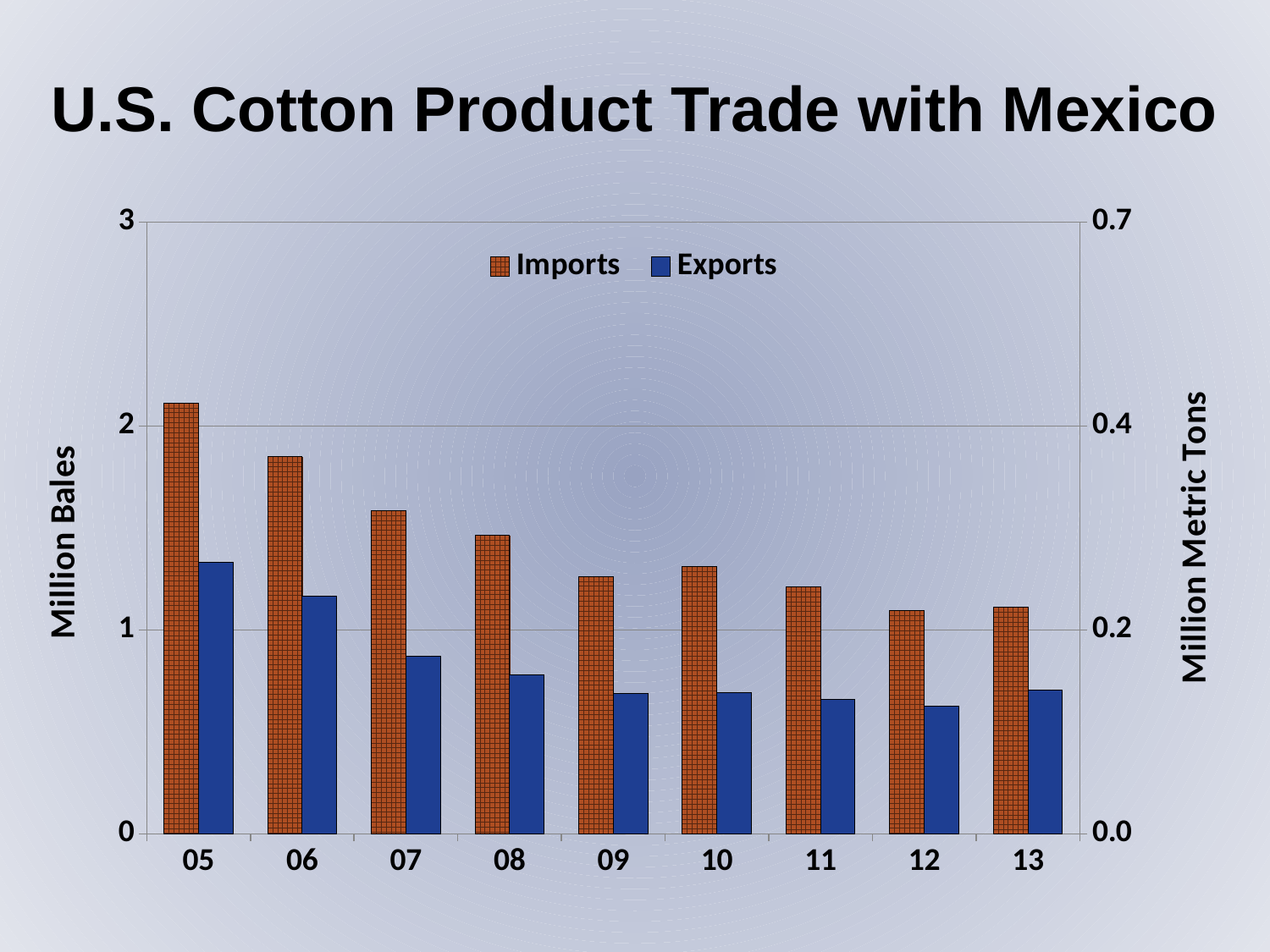
Is the Exports value for 05 greater or less than 1? greater What is the title of the chart? U.S. Cotton Product Trade with Mexico Is the Imports value for 06 greater or less than 2? less Which is larger, Imports in 05 or Imports in 13? Imports in 05 How many years are shown on the x axis? 9 Is the Imports value for 05 greater or less than 2? greater How many series does the legend list? 2 What kind of chart is shown on the slide? Bar chart In which year are Exports highest? 05 In which year are Imports highest? 05 Do Imports generally rise or fall from 05 to 13? Fall